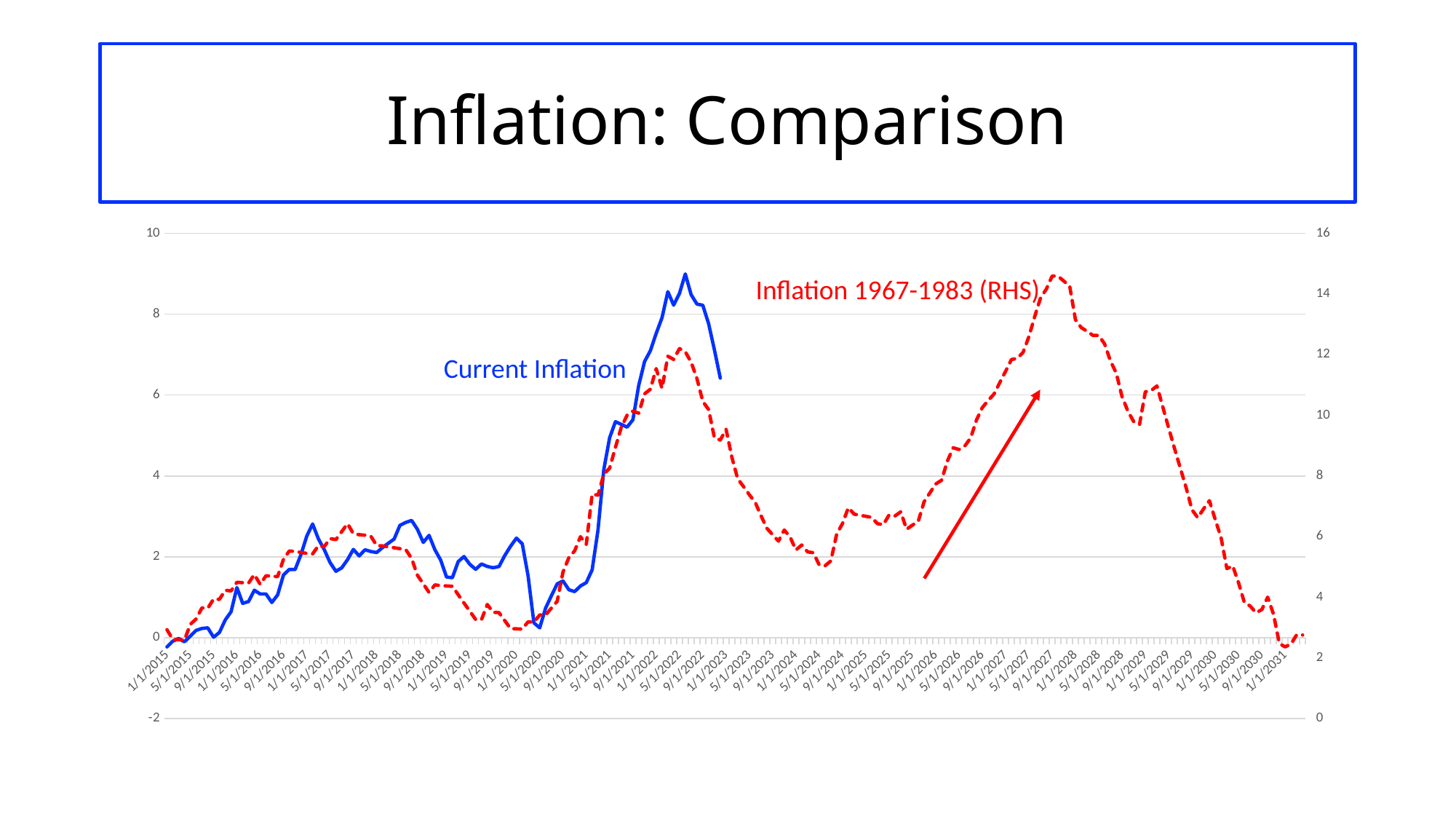
How many data series are plotted on the chart? 2 Does the Inflation 1967-1983 (RHS) series rise or fall between 1/1/2028 and 1/1/2031? fall What is the title of the slide containing the chart? Inflation: Comparison What is the maximum value shown on the right vertical axis? 16 What is the maximum value shown on the left vertical axis? 10 Is the value of the Inflation 1967-1983 (RHS) series around 1/1/2031 greater or less than 4 on the right axis? less Is the peak value of the Current Inflation series greater or less than 8 on the left axis? greater Does the Current Inflation series rise or fall between 1/1/2021 and 5/1/2022? rise Is the peak value of the Inflation 1967-1983 (RHS) series greater or less than 12 on the right axis? greater What kind of chart is shown on the slide? Line chart